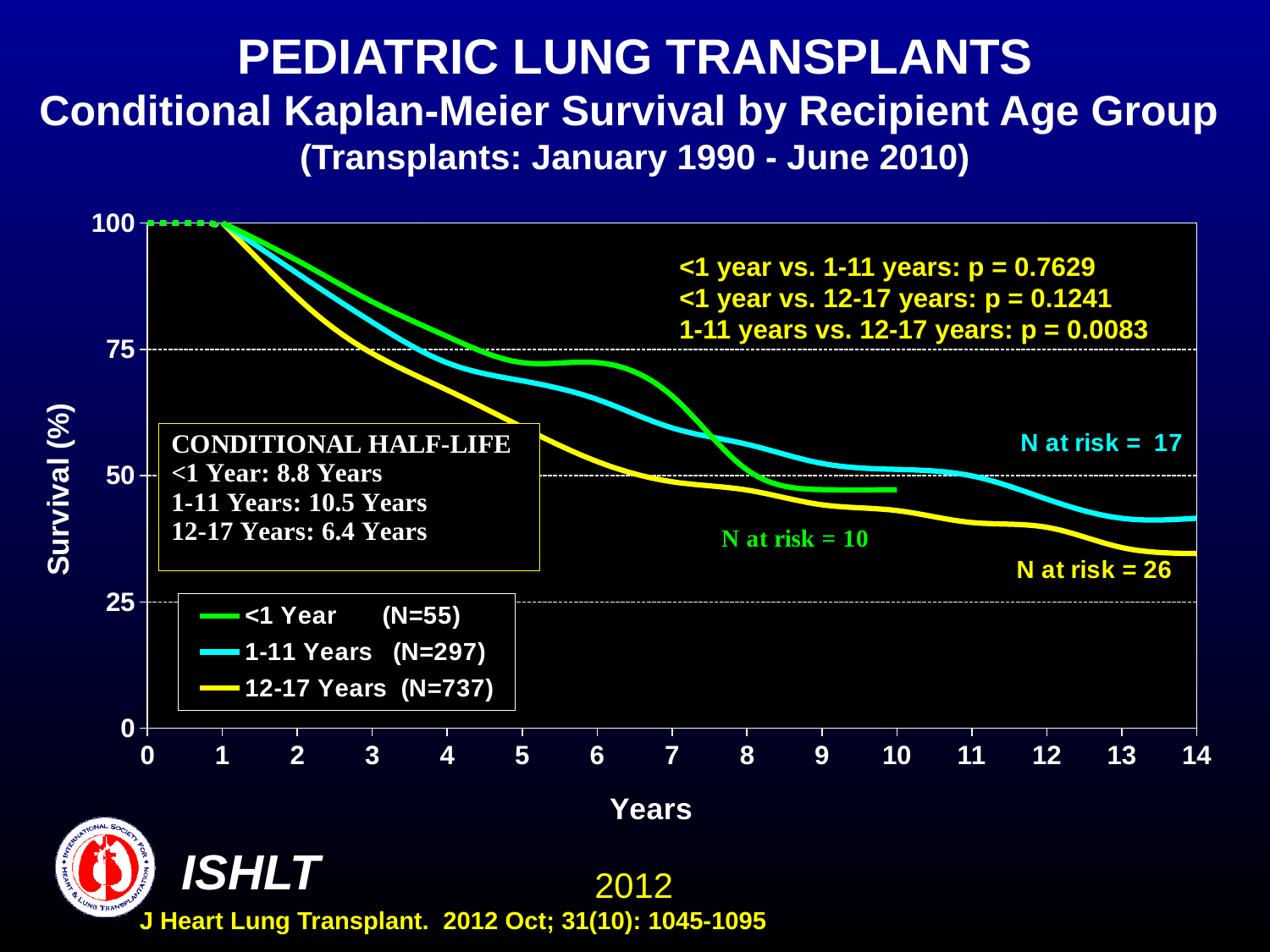
Which age group has the longest conditional half-life? 1-11 Years Do the survival curves rise or fall as years increase? fall What kind of chart is shown on the slide? line chart Is the survival value for the 12-17 Years curve at 10 years greater or less than 50? less How many series does the legend list? 3 What is the p-value for 1-11 years vs. 12-17 years? p = 0.0083 At 10 years, which curve is higher: 1-11 Years or 12-17 Years? 1-11 Years What is the N at risk shown for the 12-17 Years curve? 26 Is the survival value for the <1 Year curve at 2 years greater or less than 75? greater What is the N for the 1-11 Years group shown in the legend? N=297 Which age group has the largest N in the legend? 12-17 Years What is the conditional half-life for the 12-17 Years group? 6.4 Years